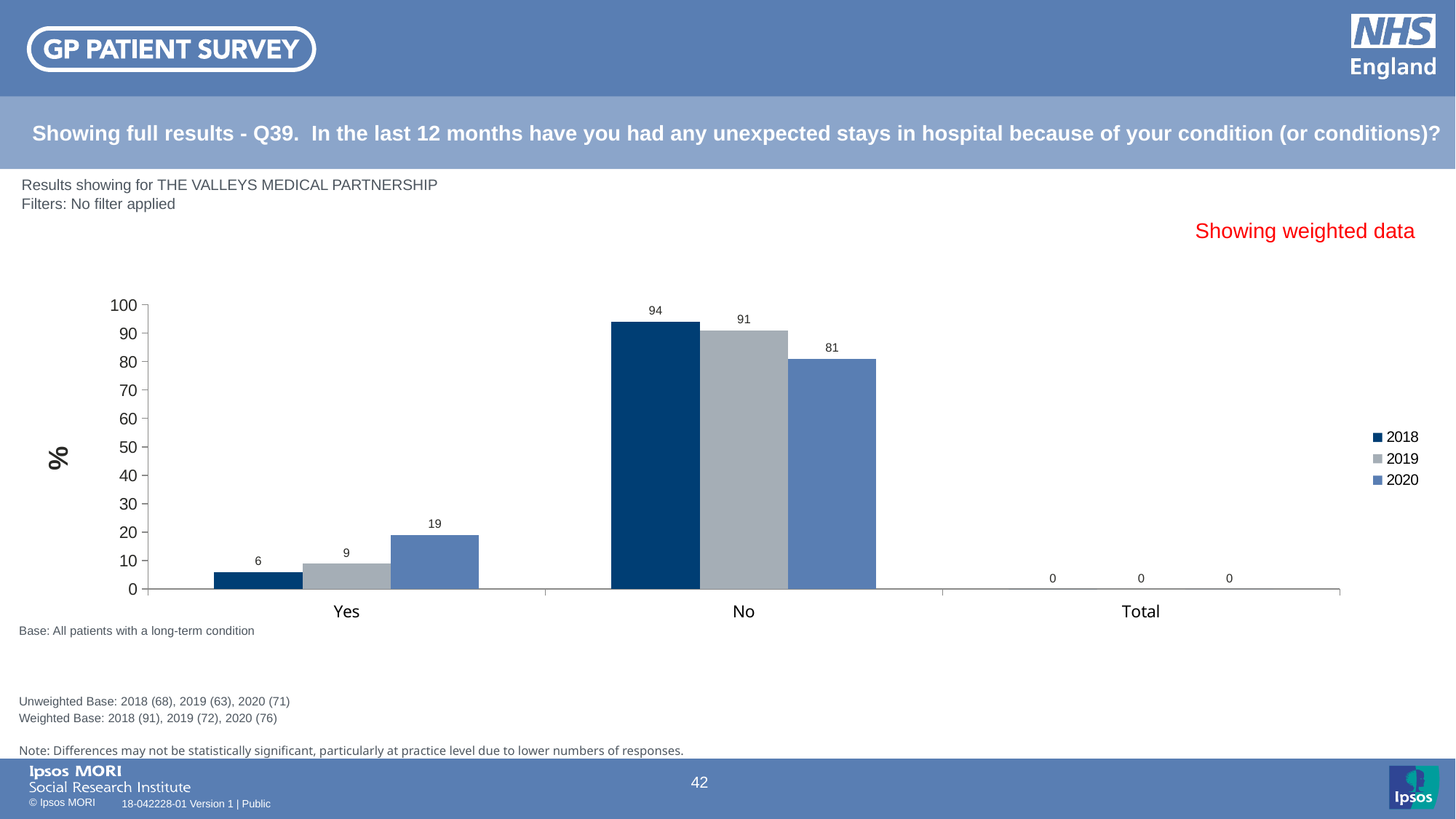
What is the value for 'No' in 2018? 94 Which year has the lowest value for 'Yes'? 2018 What is the value for 'No' in 2020? 81 What is the value for 'Yes' in 2020? 19 What kind of chart is shown on the slide? Bar chart Which year has the highest value for 'No'? 2018 How many series does the legend list? 3 Which is larger: the 2019 value for 'Yes' or the 2020 value for 'Yes'? 2020 What is the value for 'Yes' in 2018? 6 How many categories are shown on the x axis? 3 Do the values for 'No' rise or fall from 2018 to 2020? Fall What is the difference between the 2019 and 2020 values for 'No'? 10